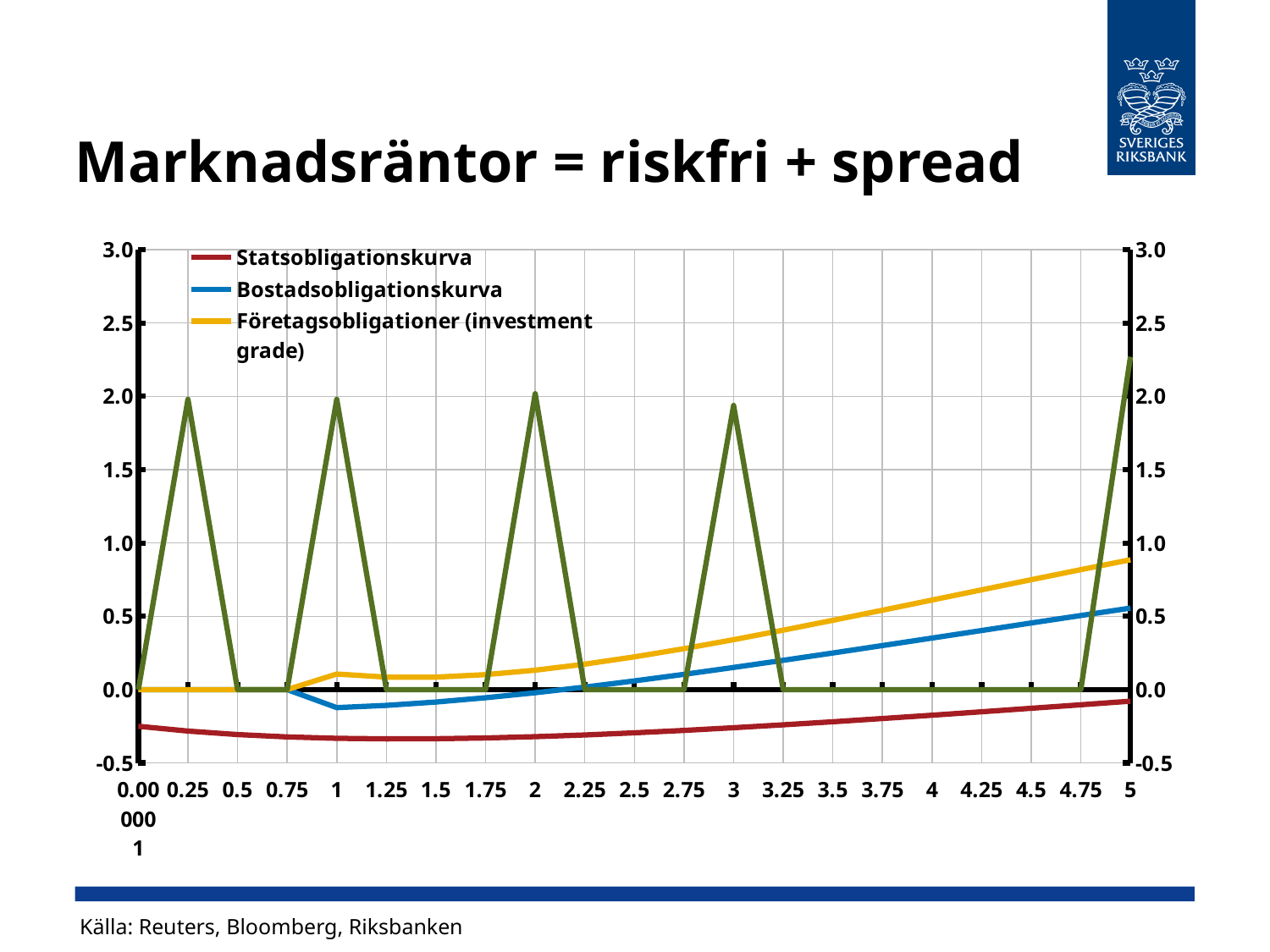
Is the value of Företagsobligationer (investment grade) at x = 2 greater or less than 0.5? less What is the title of the slide above the chart? Marknadsräntor = riskfri + spread What colour is the Bostadsobligationskurva line in the chart? blue Is the value of Bostadsobligationskurva at x = 4 greater or less than 0.5? less How many series does the chart legend list? 3 Of the three series in the legend, which has the highest value at x = 5? Företagsobligationer (investment grade) At x = 5, which is higher: Företagsobligationer (investment grade) or Bostadsobligationskurva? Företagsobligationer (investment grade) At x = 3, which is higher: Statsobligationskurva or Bostadsobligationskurva? Bostadsobligationskurva What kind of chart is shown on the slide? line chart Does the Företagsobligationer (investment grade) line rise or fall between x = 1 and x = 5? rise Is the value of Företagsobligationer (investment grade) at x = 5 greater or less than 0.5? greater